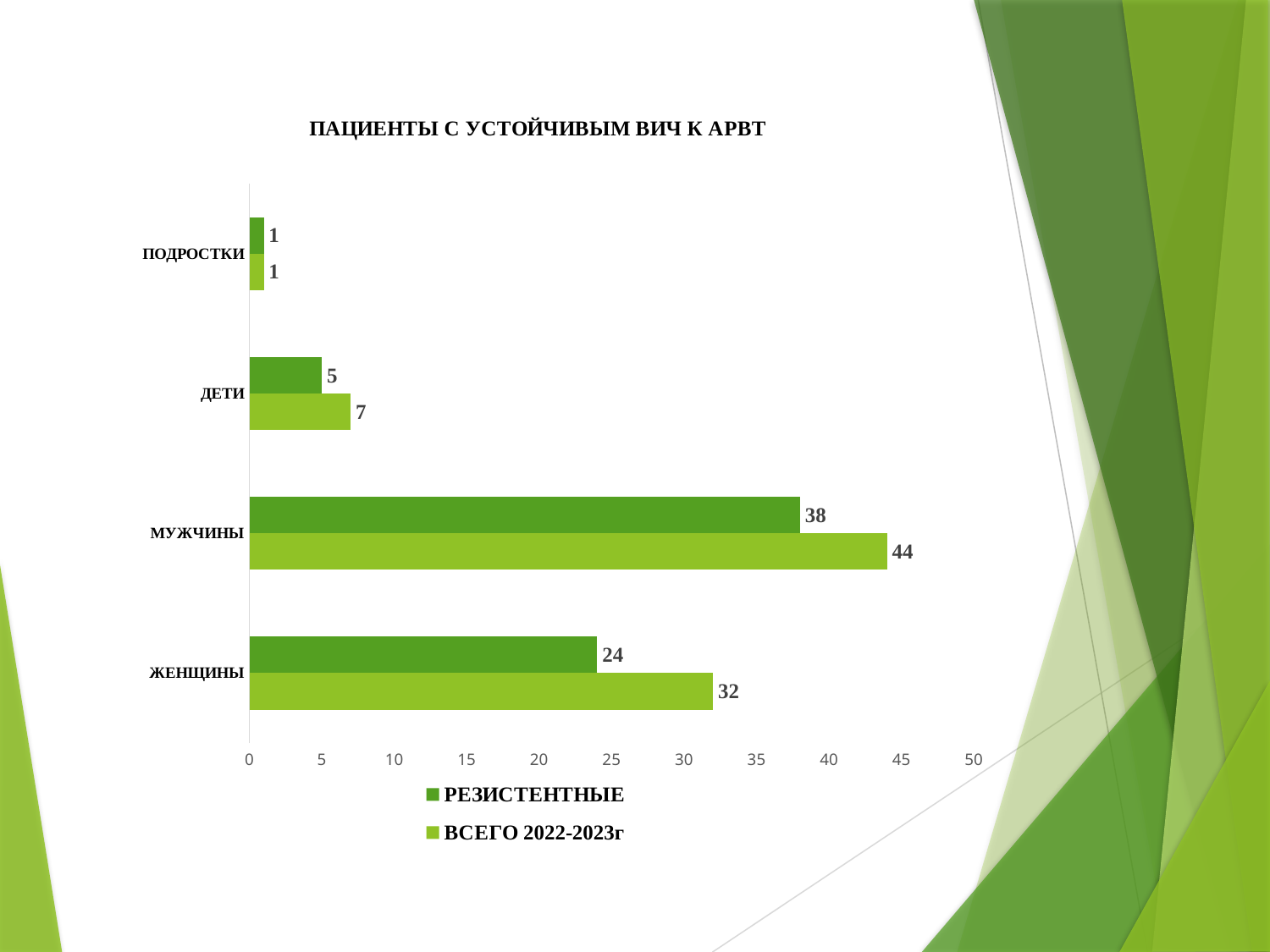
Which category has the lowest value for РЕЗИСТЕНТНЫЕ? ПОДРОСТКИ How many series does the legend list? 2 What is the difference between ВСЕГО 2022-2023г and РЕЗИСТЕНТНЫЕ for ЖЕНЩИНЫ? 8 What kind of chart is shown on the slide? Bar chart What is the title of the chart? ПАЦИЕНТЫ С УСТОЙЧИВЫМ ВИЧ К АРВТ Which category has the highest value for ВСЕГО 2022-2023г? МУЖЧИНЫ What is the value for РЕЗИСТЕНТНЫЕ in the МУЖЧИНЫ category? 38 What is the value for ВСЕГО 2022-2023г in the ЖЕНЩИНЫ category? 32 Which is larger: the РЕЗИСТЕНТНЫЕ value for МУЖЧИНЫ or the ВСЕГО 2022-2023г value for ЖЕНЩИНЫ? РЕЗИСТЕНТНЫЕ value for МУЖЧИНЫ How many categories are shown on the chart? 4 What is the value for ВСЕГО 2022-2023г in the ДЕТИ category? 7 What is the difference between ВСЕГО 2022-2023г and РЕЗИСТЕНТНЫЕ for МУЖЧИНЫ? 6